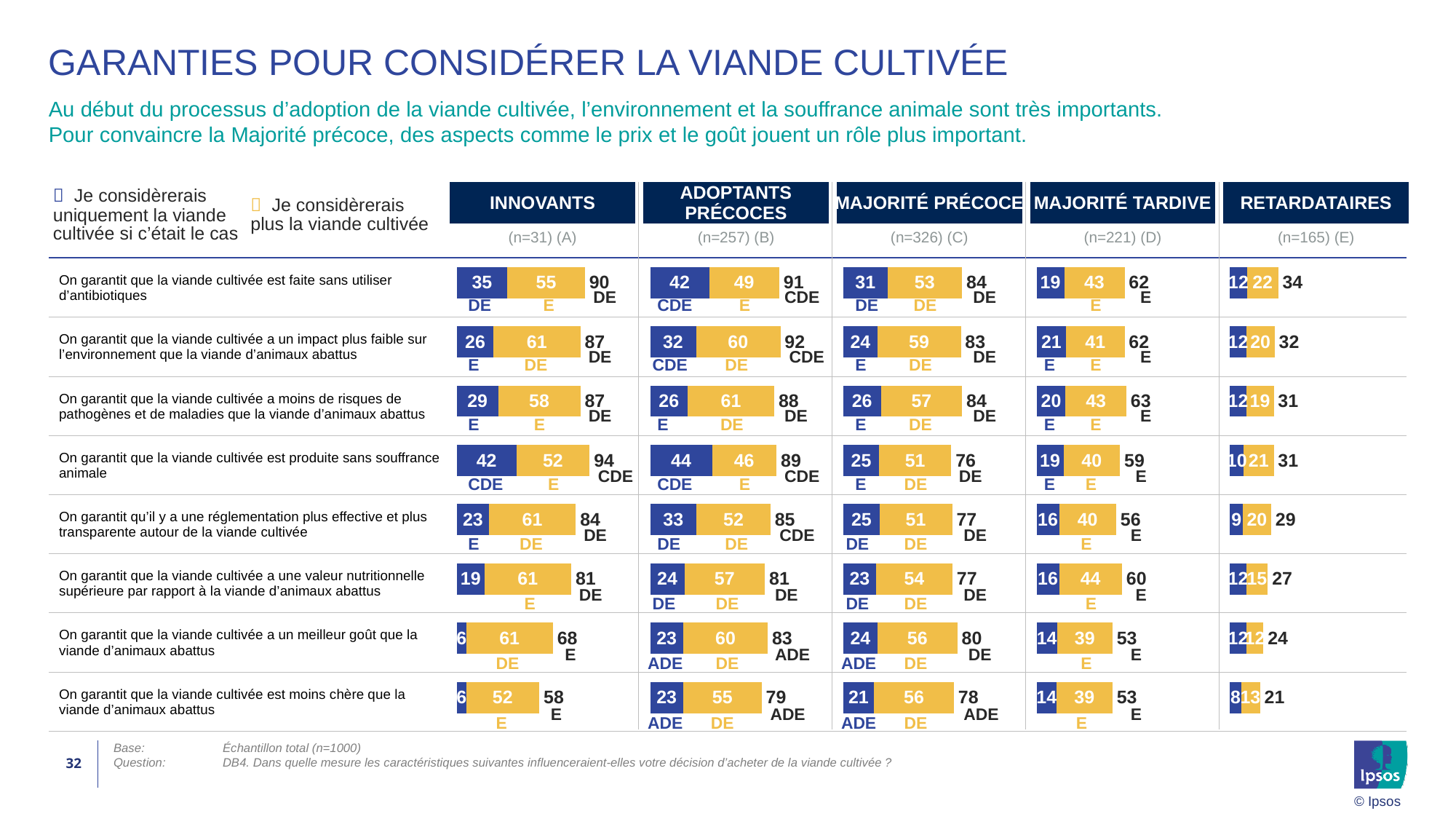
In the RETARDATAIRES column, which guarantee has the lowest total? On garantit que la viande cultivée est moins chère que la viande d'animaux abattus In the MAJORITÉ PRÉCOCE column, what is the total of the stacked bar for "On garantit que la viande cultivée est faite sans utiliser d'antibiotiques"? 84 In the INNOVANTS column, which guarantee has the highest total? On garantit que la viande cultivée est produite sans souffrance animale What is the sample size shown for the MAJORITÉ PRÉCOCE column? n=326 In the INNOVANTS column, what is the dark blue value ("Je considèrerais uniquement la viande cultivée si c'était le cas") for "On garantit que la viande cultivée est produite sans souffrance animale"? 42 In the MAJORITÉ TARDIVE column, what is the yellow value ("Je considèrerais plus la viande cultivée") for "On garantit que la viande cultivée a une valeur nutritionnelle supérieure par rapport à la viande d'animaux abattus"? 44 How many guarantees (rows of bars) are shown on the slide? 8 For "On garantit que la viande cultivée a un meilleur goût que la viande d'animaux abattus", which column has the larger total: MAJORITÉ PRÉCOCE or MAJORITÉ TARDIVE? MAJORITÉ PRÉCOCE How many series does the legend list? 2 What kind of chart is used in each cell of the table? Stacked bar chart In the RETARDATAIRES column, what is the dark blue value for "On garantit qu'il y a une réglementation plus effective et plus transparente autour de la viande cultivée"? 9 In the ADOPTANTS PRÉCOCES column, what is the difference between the total for "faite sans utiliser d'antibiotiques" and the total for "moins chère que la viande d'animaux abattus"? 12